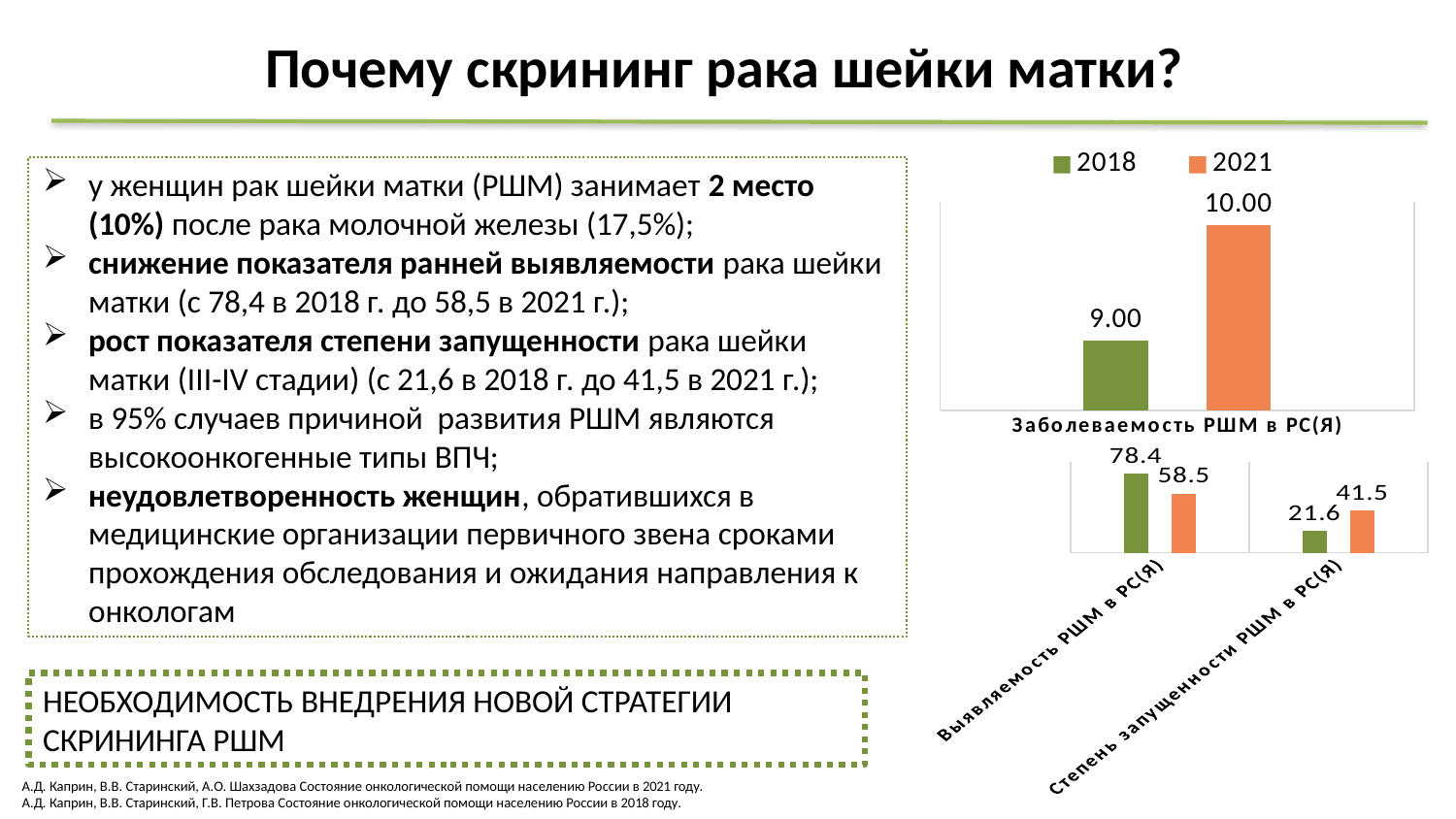
In the bottom chart, what is the 2021 (orange) value for Степень запущенности РШМ в РС(Я)? 41.5 In the bottom chart, what is the 2021 (orange) value for Выявляемость РШМ в РС(Я)? 58.5 In the top chart (Заболеваемость РШМ в РС(Я)), what is the difference between the 2021 and 2018 values? 1.00 In the bottom chart, what is the 2018 (green) value for Выявляемость РШМ в РС(Я)? 78.4 In the bottom chart, what is the difference between the 2018 and 2021 values for Выявляемость РШМ в РС(Я)? 19.9 In the top chart (Заболеваемость РШМ в РС(Я)), what is the value for 2021? 10.00 In the top chart (Заболеваемость РШМ в РС(Я)), what is the value for 2018? 9.00 How many series does the legend of the top chart list? 2 In the bottom chart, what is the 2018 (green) value for Степень запущенности РШМ в РС(Я)? 21.6 What type of chart is the top chart on the slide? Bar chart In the top chart (Заболеваемость РШМ в РС(Я)), which year has the higher value, 2018 or 2021? 2021 In the bottom chart, how many categories are shown on the x axis? 2